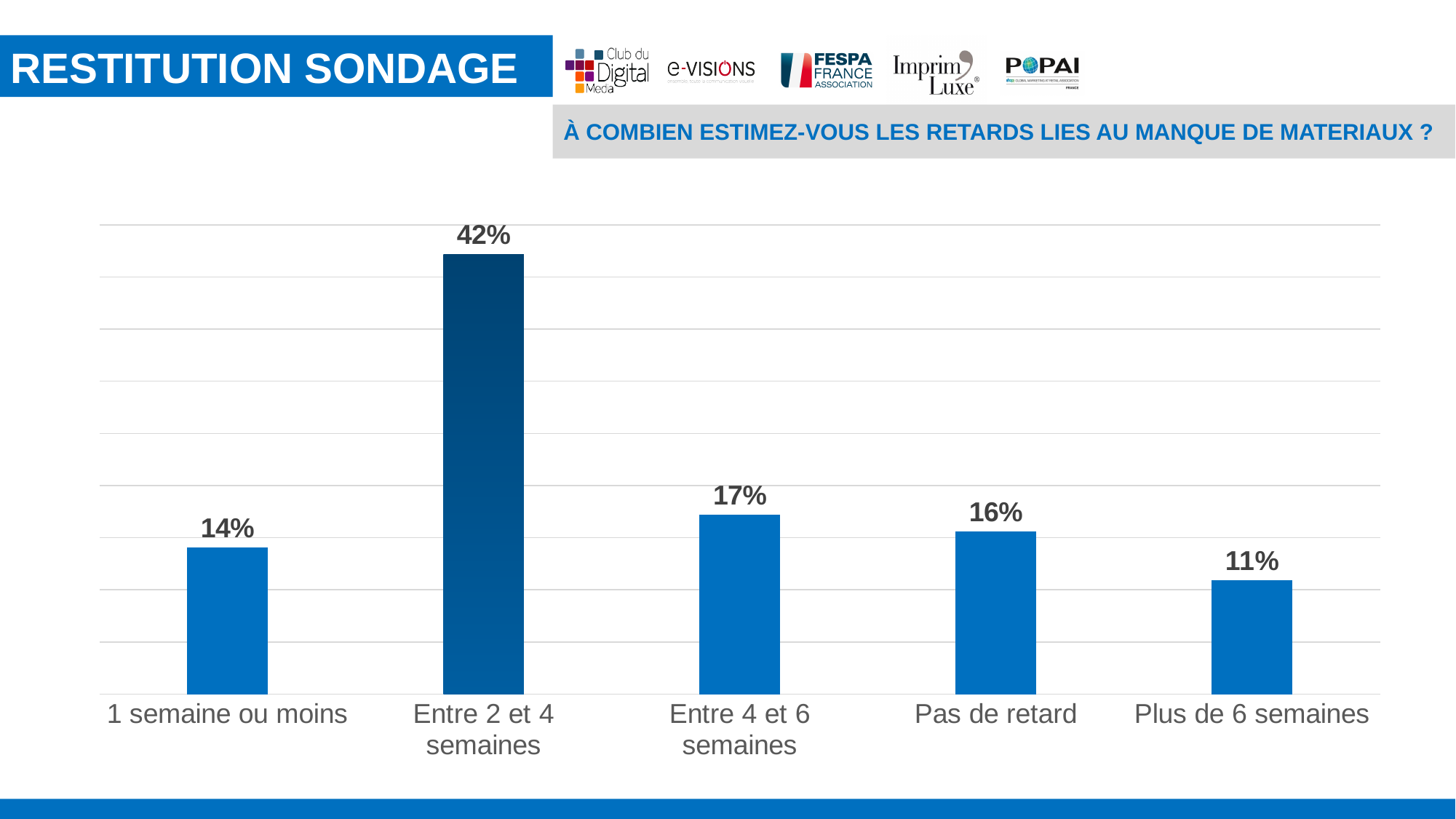
How many categories are shown on the chart? 5 What is the difference between the values for "Entre 2 et 4 semaines" and "Entre 4 et 6 semaines"? 25% Which category has the lowest value? Plus de 6 semaines What is the value for "1 semaine ou moins"? 14% What is the value for "Entre 2 et 4 semaines"? 42% What is the value for "Pas de retard"? 16% What is the value for "Plus de 6 semaines"? 11% Which is larger, the value for "1 semaine ou moins" or the value for "Pas de retard"? Pas de retard What is the difference between the values for "Entre 4 et 6 semaines" and "Plus de 6 semaines"? 6% What kind of chart is shown on the slide? Bar chart Which category has the highest value? Entre 2 et 4 semaines What question does the chart on the slide answer? À combien estimez-vous les retards lies au manque de materiaux ?